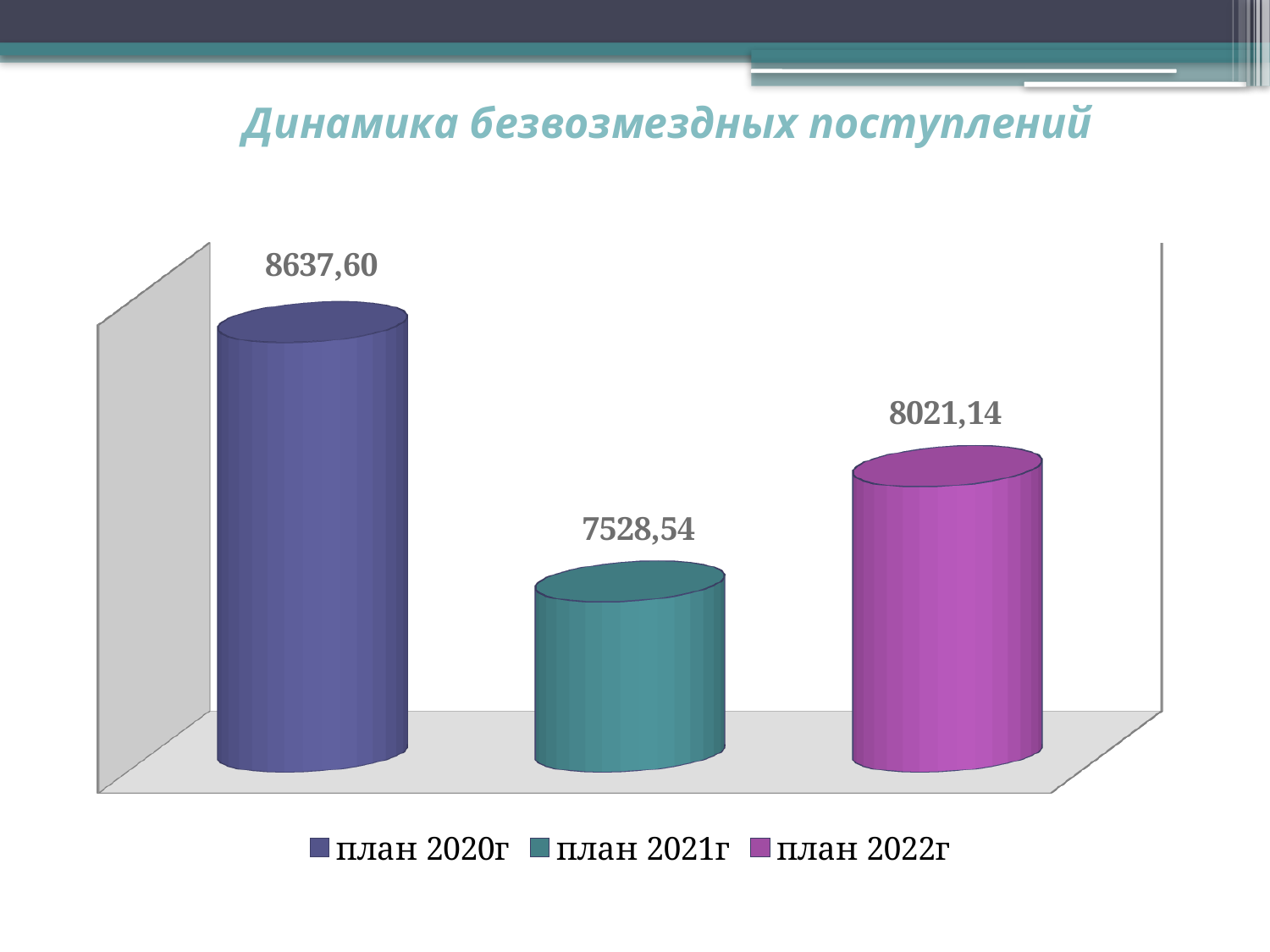
What is the difference between the values for план 2020г and план 2021г? 1109,06 How many series does the legend list? 3 What kind of chart is shown on the slide? bar chart Which is larger, the value for план 2022г or the value for план 2021г? план 2022г What is the value for план 2021г? 7528,54 Which series has the highest value? план 2020г What is the title of the chart? Динамика безвозмездных поступлений How many bars are plotted on the chart? 3 What is the difference between the values for план 2022г and план 2021г? 492,60 What is the value for план 2020г? 8637,60 Which series has the lowest value? план 2021г What is the value for план 2022г? 8021,14